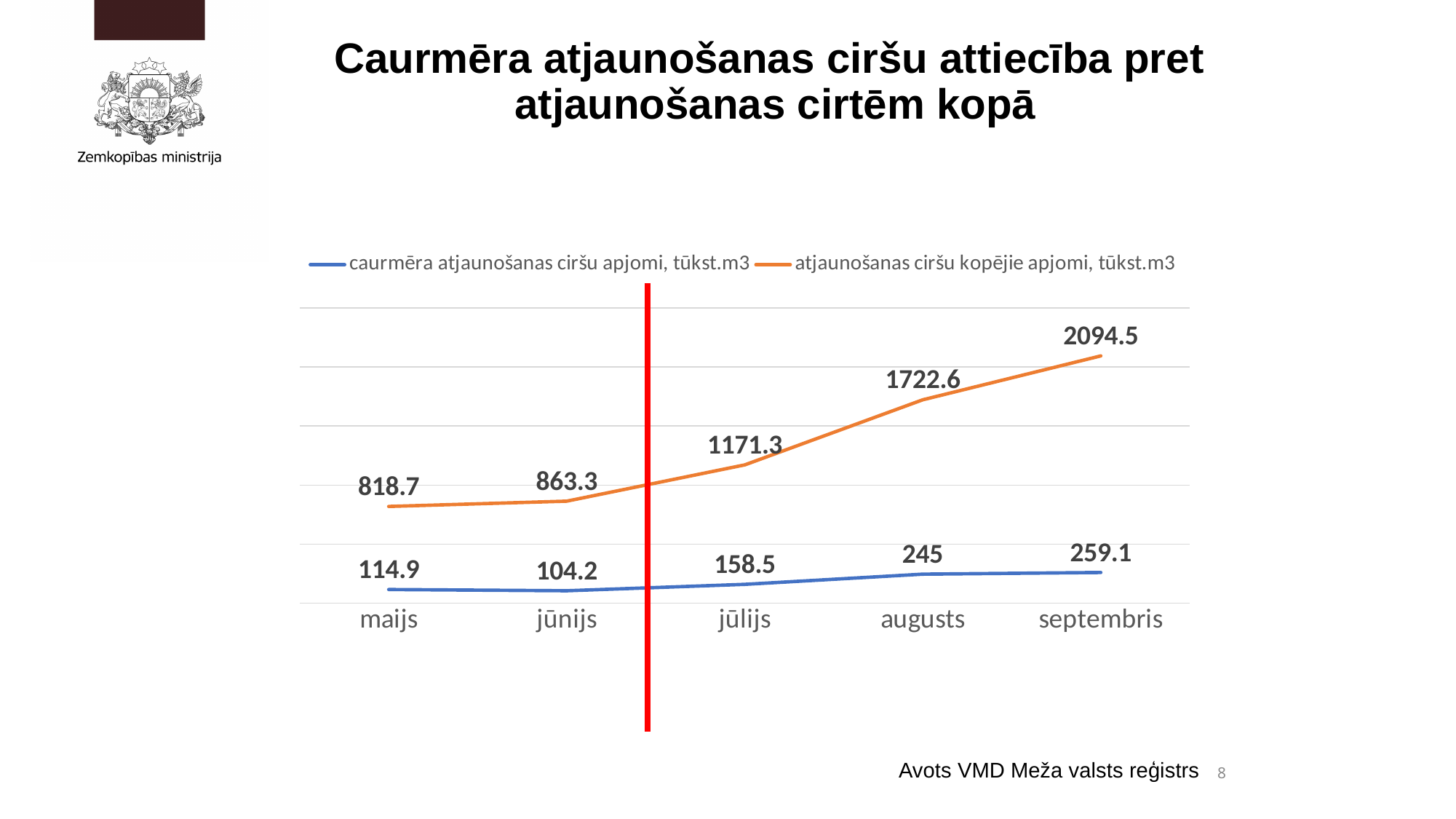
What is the value of 'atjaunošanas ciršu kopējie apjomi, tūkst.m3' for septembris? 2094.5 What is the difference between the 'caurmēra atjaunošanas ciršu apjomi, tūkst.m3' values for augusts and jūlijs? 86.5 In which month is 'atjaunošanas ciršu kopējie apjomi, tūkst.m3' highest? septembris How many series does the legend list? 2 What is the value of 'caurmēra atjaunošanas ciršu apjomi, tūkst.m3' for jūnijs? 104.2 Does 'atjaunošanas ciršu kopējie apjomi, tūkst.m3' rise or fall from jūnijs to septembris? rise What type of chart is shown on the slide? line chart Which is larger: 'caurmēra atjaunošanas ciršu apjomi, tūkst.m3' in maijs or in septembris? septembris In which month is 'caurmēra atjaunošanas ciršu apjomi, tūkst.m3' lowest? jūnijs What is the difference between the 'atjaunošanas ciršu kopējie apjomi, tūkst.m3' values for septembris and augusts? 371.9 How many months are shown on the x axis? 5 What is the value of 'atjaunošanas ciršu kopējie apjomi, tūkst.m3' for jūlijs? 1171.3